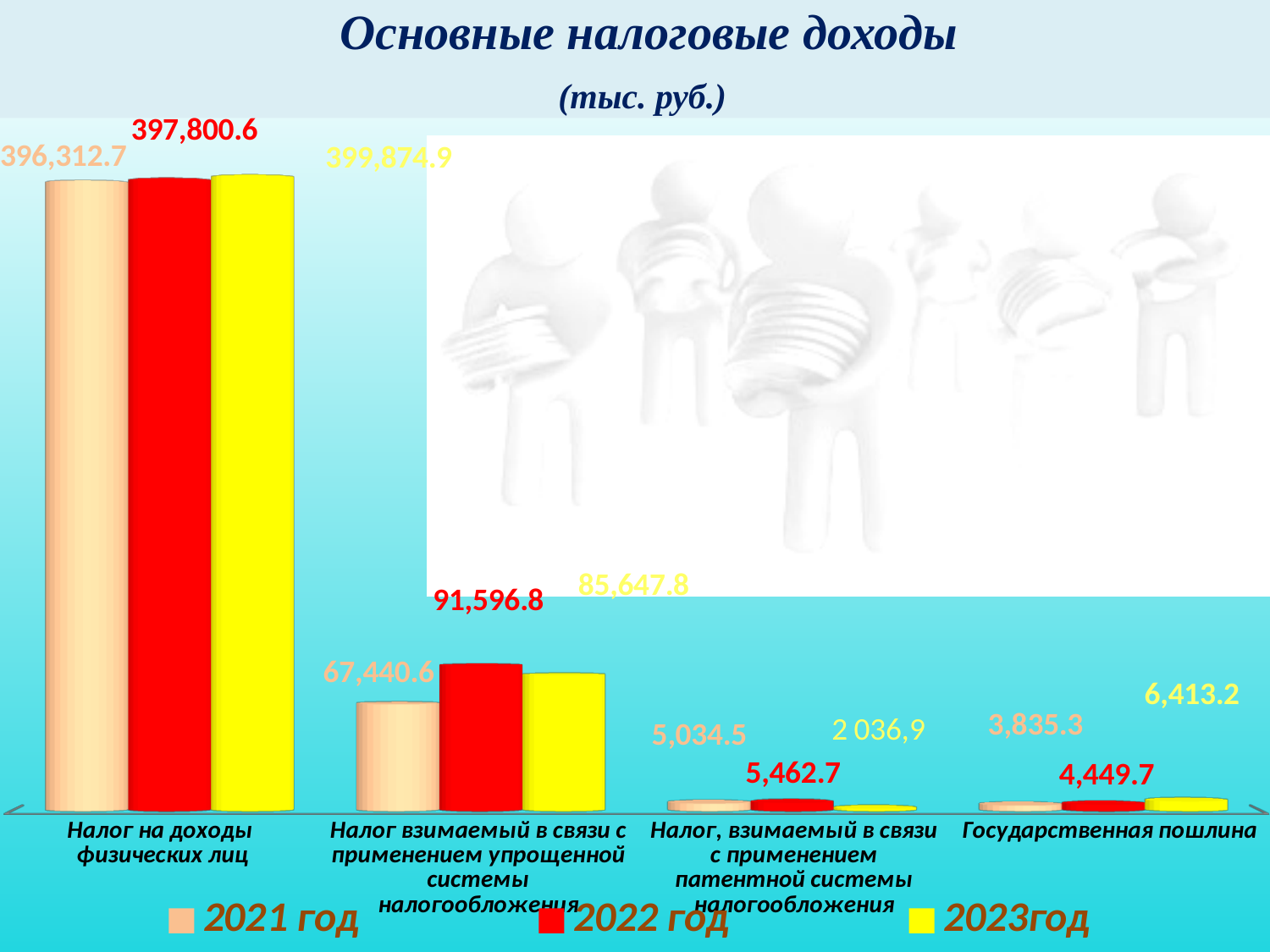
What is the value for 2022 год for Налог на доходы физических лиц? 397,800.6 How many categories are shown on the x axis? 4 Which category has the highest values across all years? Налог на доходы физических лиц How many series does the legend list? 3 Which is larger for Государственная пошлина: the 2021 год value or the 2023год value? 2023год What type of chart is shown on the slide? Bar chart Do the values for Государственная пошлина rise or fall from 2021 год to 2023год? Rise What is the value for 2023год for Государственная пошлина? 6,413.2 What is the difference between the 2022 год and 2021 год values for Налог взимаемый в связи с применением упрощенной системы налогообложения? 24,156.2 What is the value for 2023год for Налог, взимаемый в связи с применением патентной системы налогообложения? 2 036,9 Which year has the highest value for Налог взимаемый в связи с применением упрощенной системы налогообложения? 2022 год What is the value for 2021 год for Налог взимаемый в связи с применением упрощенной системы налогообложения? 67,440.6